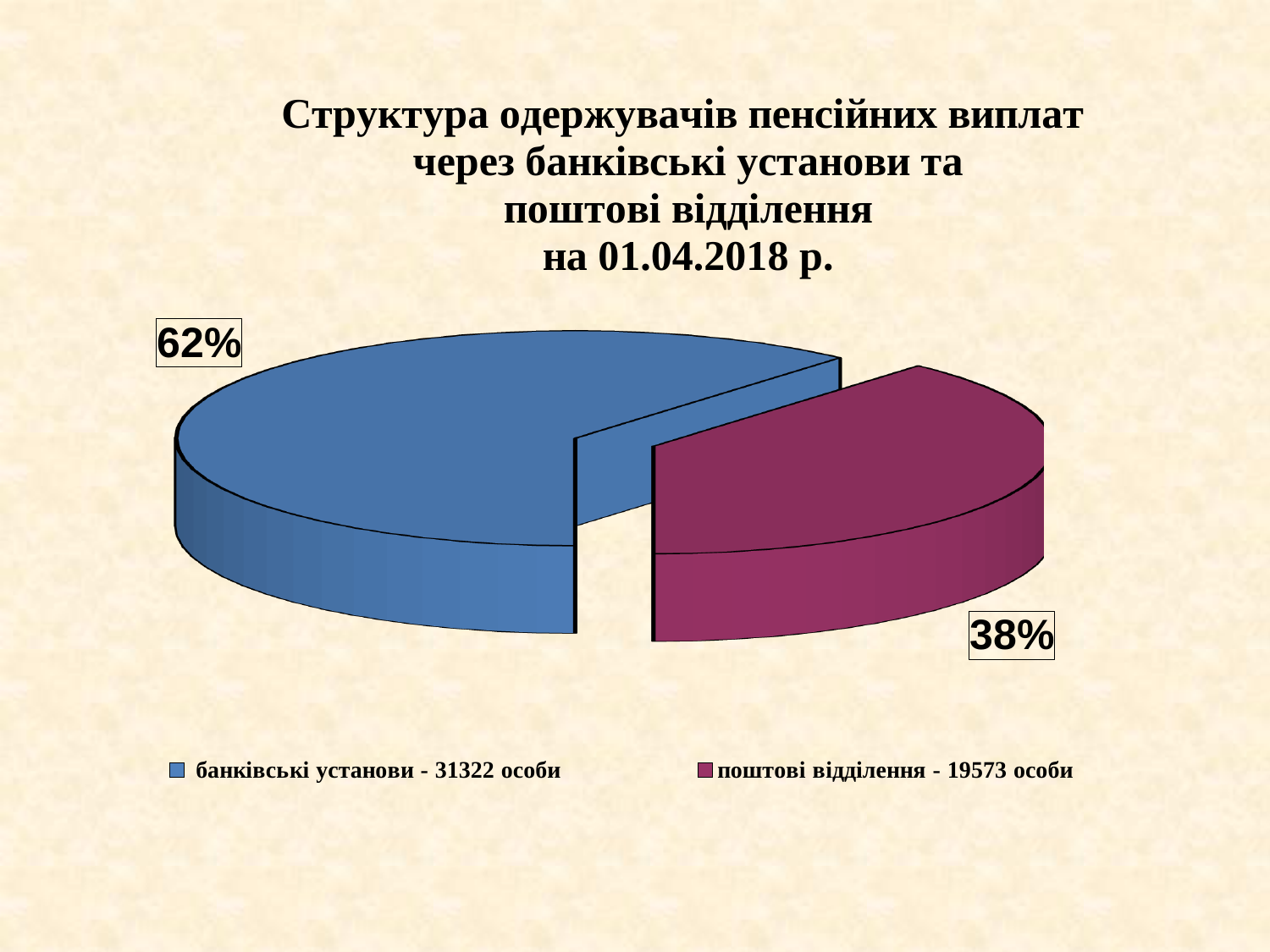
How many slices does the pie chart have? 2 What colour is the slice for поштові відділення? purple Which category has the smallest slice of the pie? поштові відділення What share of the pie does the slice for поштові відділення represent? 38% How many entries does the legend list? 2 According to the legend, how many people receive pension payments through поштові відділення? 19573 особи What share of the pie does the slice for банківські установи represent? 62% Which category has the largest slice of the pie? банківські установи What is the difference in percentage points between the банківські установи slice and the поштові відділення slice? 24 Which is larger: the share for банківські установи or the share for поштові відділення? банківські установи What kind of chart is shown on the slide? pie chart According to the legend, how many people receive pension payments through банківські установи? 31322 особи